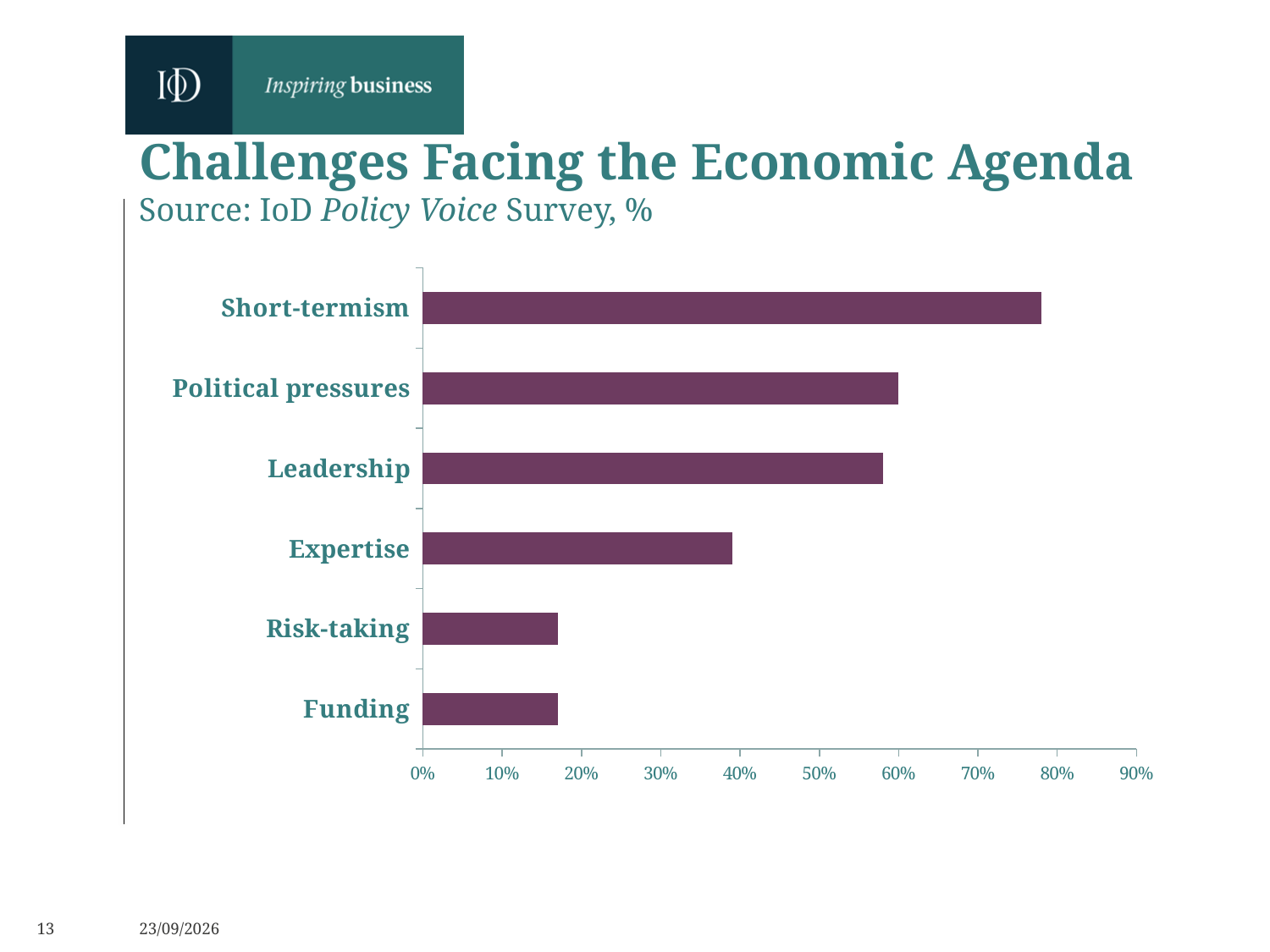
Is the value for Leadership greater or less than 50%? greater Is the value for Expertise greater or less than 30%? greater Is the value for Short-termism greater or less than 70%? greater What kind of chart is shown on the slide? bar chart How many categories are plotted in the chart? 6 Which has the larger value, Expertise or Leadership? Leadership Which has the larger value, Short-termism or Political pressures? Short-termism Which category has the highest value in the chart? Short-termism What is the highest value shown on the chart's horizontal axis? 90% What is the title of the slide's chart? Challenges Facing the Economic Agenda